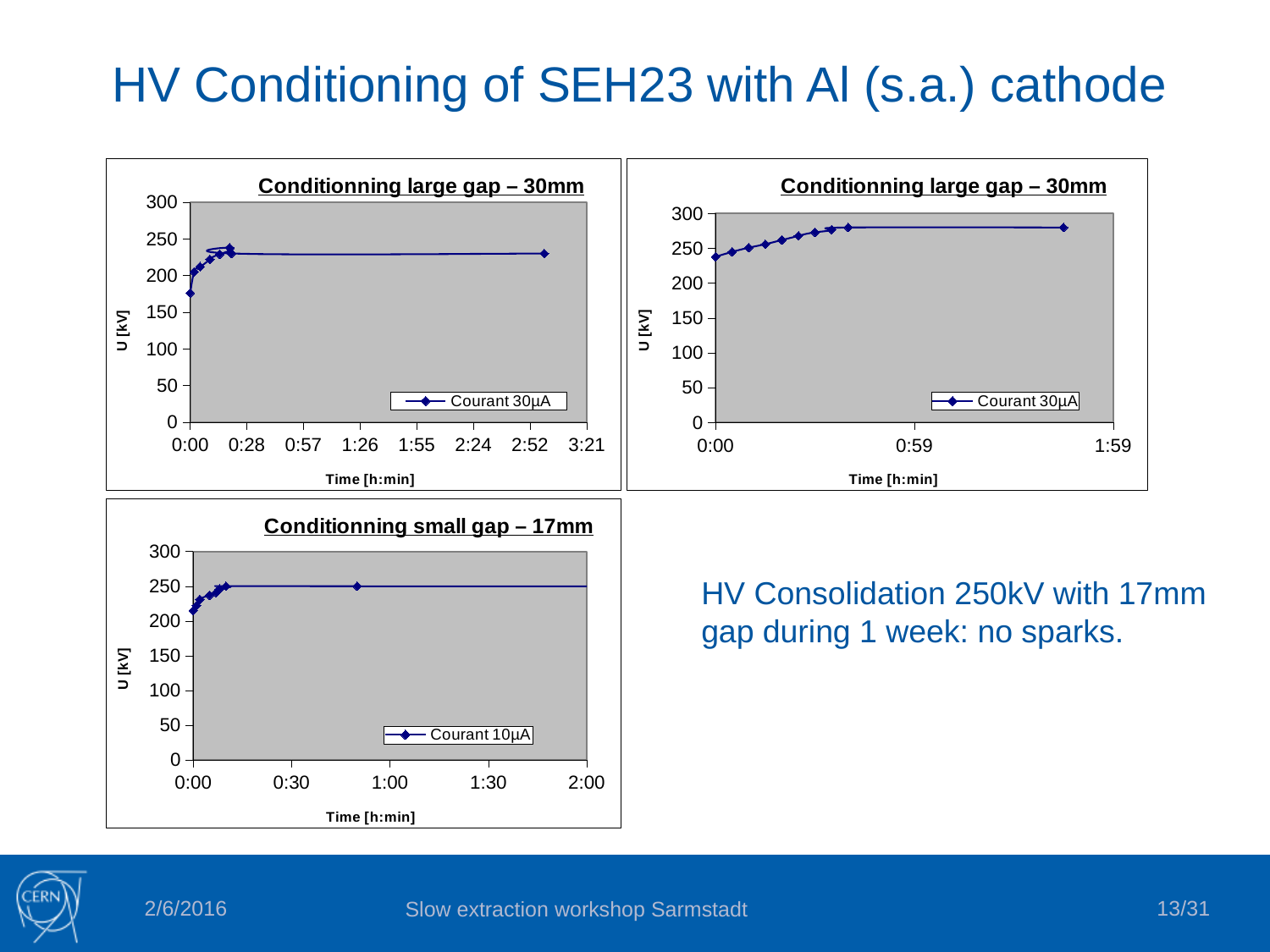
In the top-left chart "Conditionning large gap – 30mm", is the value of the first point at 0:00 greater or less than 200? less How many series does the legend of the top-left chart "Conditionning large gap – 30mm" list? 1 In the top-right chart "Conditionning large gap – 30mm", is the value of the first point at 0:00 greater or less than 250? less In the bottom-left chart "Conditionning small gap – 17mm", is the value of the last point at 2:00 greater or less than 200? greater In the bottom-left chart "Conditionning small gap – 17mm", do the values rise or fall over the first few points after 0:00? rise What kind of chart is the top-left chart titled "Conditionning large gap – 30mm"? line chart What is the legend entry of the top-right chart "Conditionning large gap – 30mm"? Courant 30µA How many series does the legend of the bottom-left chart "Conditionning small gap – 17mm" list? 1 What is the legend entry of the bottom-left chart "Conditionning small gap – 17mm"? Courant 10µA In the top-right chart "Conditionning large gap – 30mm", do the values rise or fall from 0:00 to the last point? rise